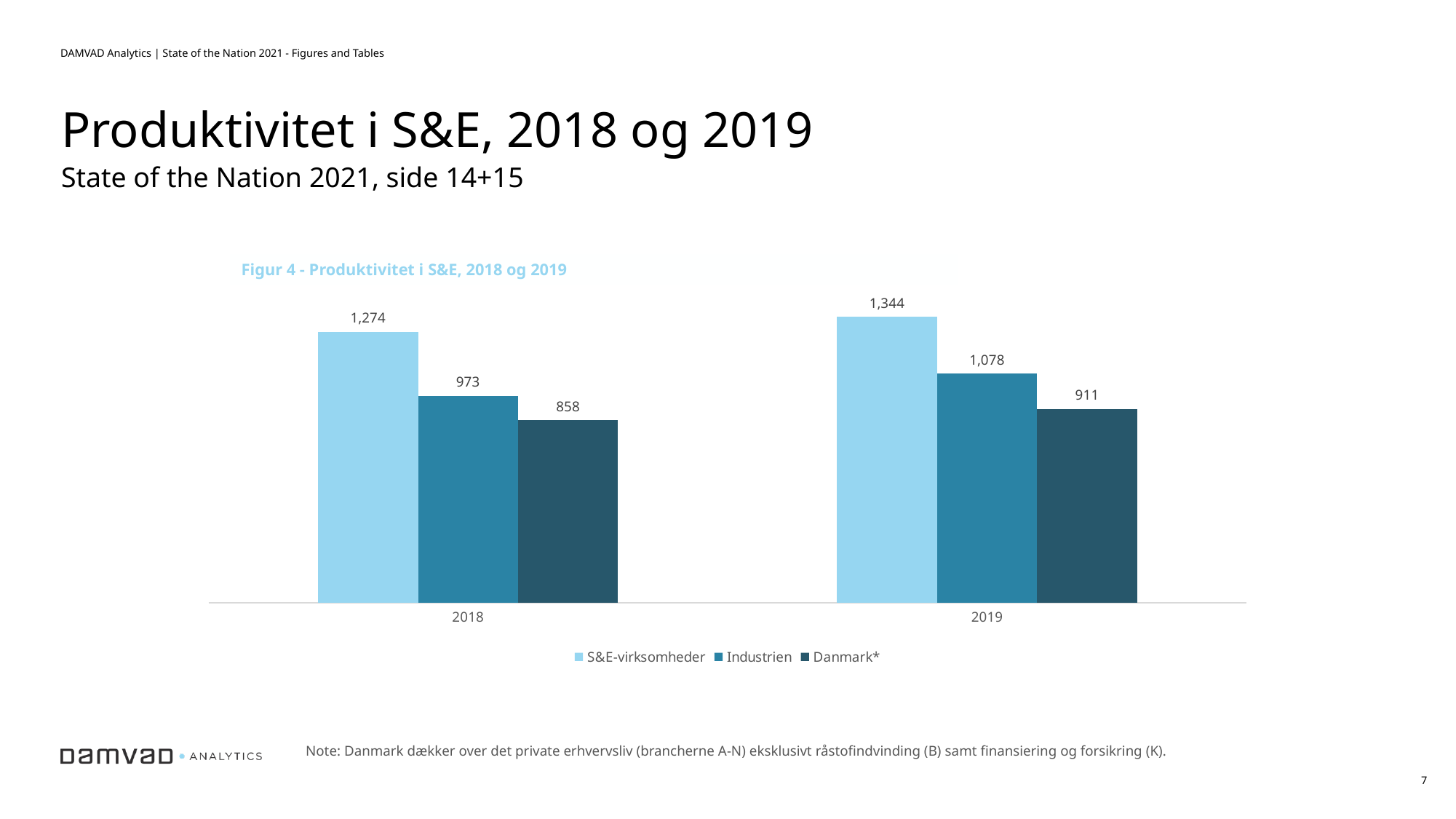
How many series does the legend list? 3 What kind of chart is shown? Bar chart Which is larger: Industrien in 2018 or Danmark* in 2019? Industrien in 2018 What is the value for Danmark* in 2018? 858 What is the value for S&E-virksomheder in 2018? 1,274 How many year categories are shown on the x axis? 2 What is the value for Industrien in 2019? 1,078 Which series has the lowest value in 2018? Danmark* What is the difference between the S&E-virksomheder values for 2019 and 2018? 70 Which series has the highest value in 2019? S&E-virksomheder Does the value for Danmark* rise or fall from 2018 to 2019? Rise What is the difference between Industrien and Danmark* in 2019? 167